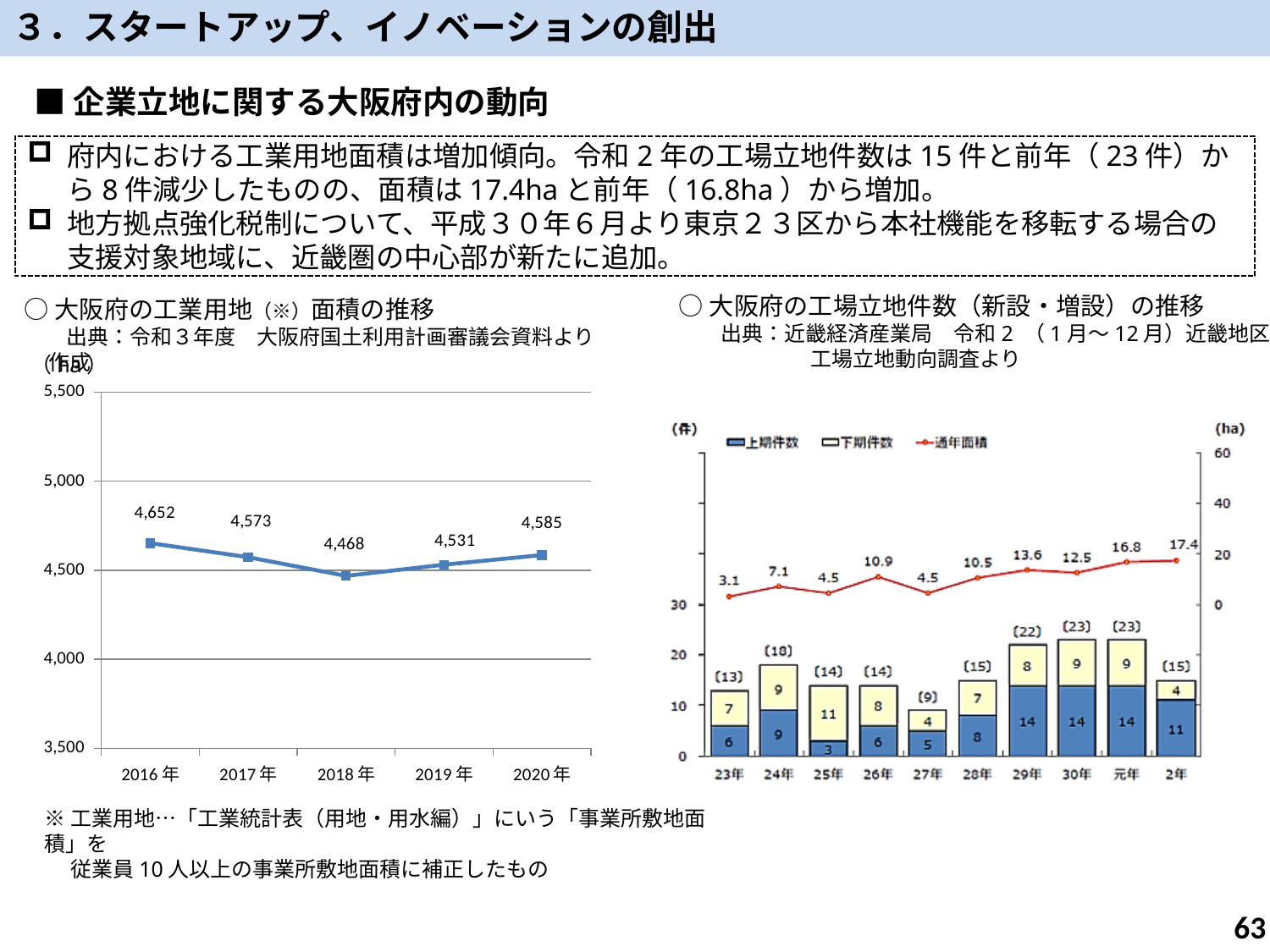
In the left chart (大阪府の工業用地面積の推移), what is the value for 2016年? 4,652 What type of chart is the left chart (大阪府の工業用地面積の推移)? Line chart In the left chart (大阪府の工業用地面積の推移), which year has the highest value? 2016年 In the right chart (大阪府の工場立地件数の推移), is the 通年面積 value for 26年 larger or smaller than the value for 27年? Larger In the right chart (大阪府の工場立地件数の推移), what is the 上期件数 value for 29年? 14 In the right chart (大阪府の工場立地件数の推移), what is the 通年面積 value for 2年? 17.4 In the right chart (大阪府の工場立地件数の推移), what is the total number of cases for 24年? 18 In the left chart (大阪府の工業用地面積の推移), what is the difference between the 2020年 value and the 2018年 value? 117 In the right chart (大阪府の工場立地件数の推移), how many series does the legend list? 3 In the right chart (大阪府の工場立地件数の推移), which year has the lowest total number of cases? 27年 In the left chart (大阪府の工業用地面積の推移), which year has the lowest value? 2018年 In the left chart (大阪府の工業用地面積の推移), how many data points are plotted? 5